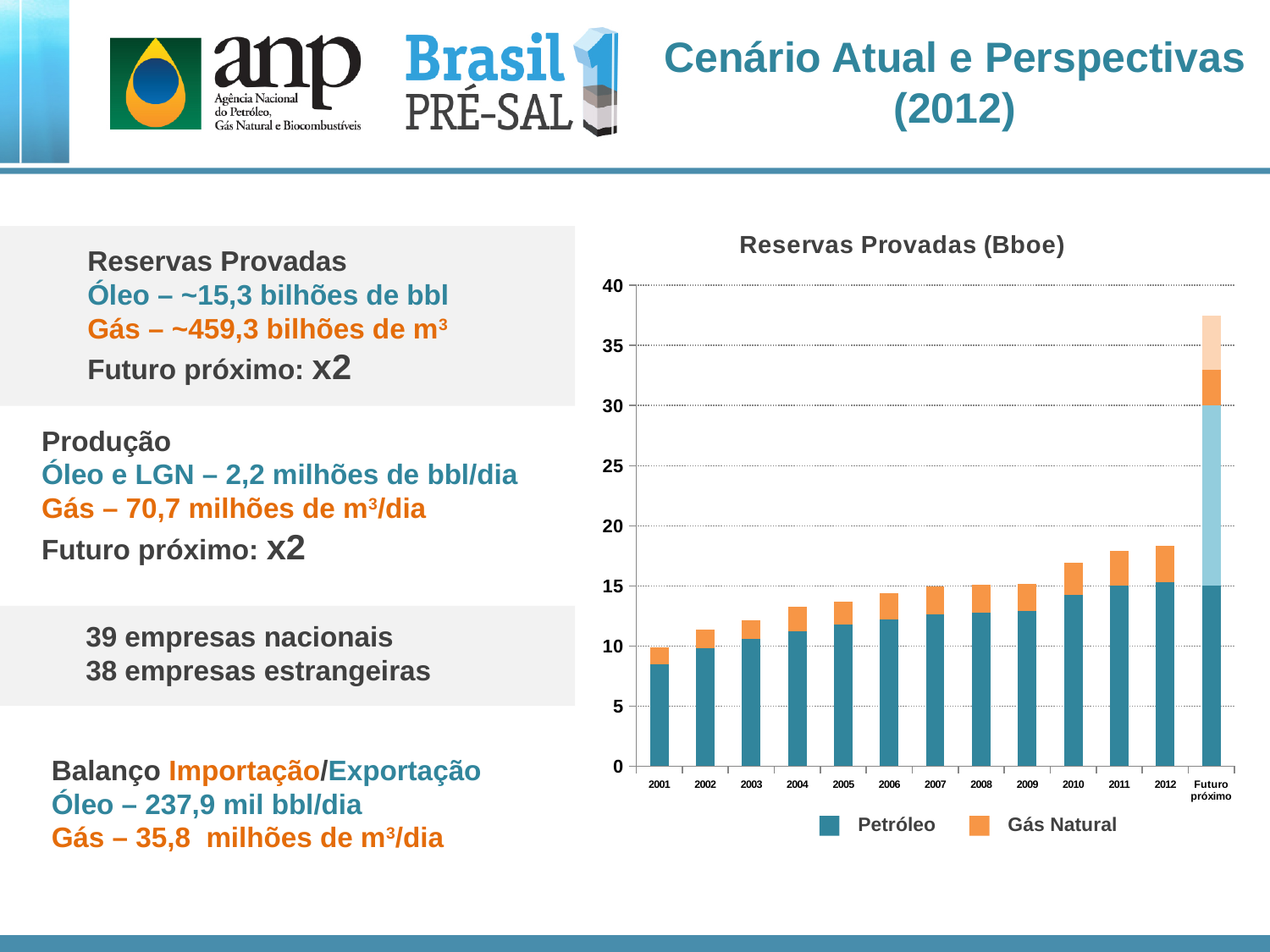
How many categories are shown on the x axis of the "Reservas Provadas (Bboe)" chart? 13 In the "Reservas Provadas (Bboe)" chart, is the total stacked value for 2012 greater or less than 20? less In the "Reservas Provadas (Bboe)" chart, which series is larger in 2012, Petróleo or Gás Natural? Petróleo What kind of chart is shown under the title "Reservas Provadas (Bboe)"? Stacked bar chart Which year has the shortest stacked bar in the "Reservas Provadas (Bboe)" chart? 2001 Which category has the tallest stacked bar in the "Reservas Provadas (Bboe)" chart? Futuro próximo How many series does the legend of the "Reservas Provadas (Bboe)" chart list? 2 In the "Reservas Provadas (Bboe)" chart, do the total reserves rise or fall from 2001 to 2012? Rise In the "Reservas Provadas (Bboe)" chart, is the total stacked value for Futuro próximo greater or less than 35? greater In the "Reservas Provadas (Bboe)" chart, is the Petróleo value for 2005 greater or less than 10? greater Which two series are listed in the legend of the "Reservas Provadas (Bboe)" chart? Petróleo and Gás Natural